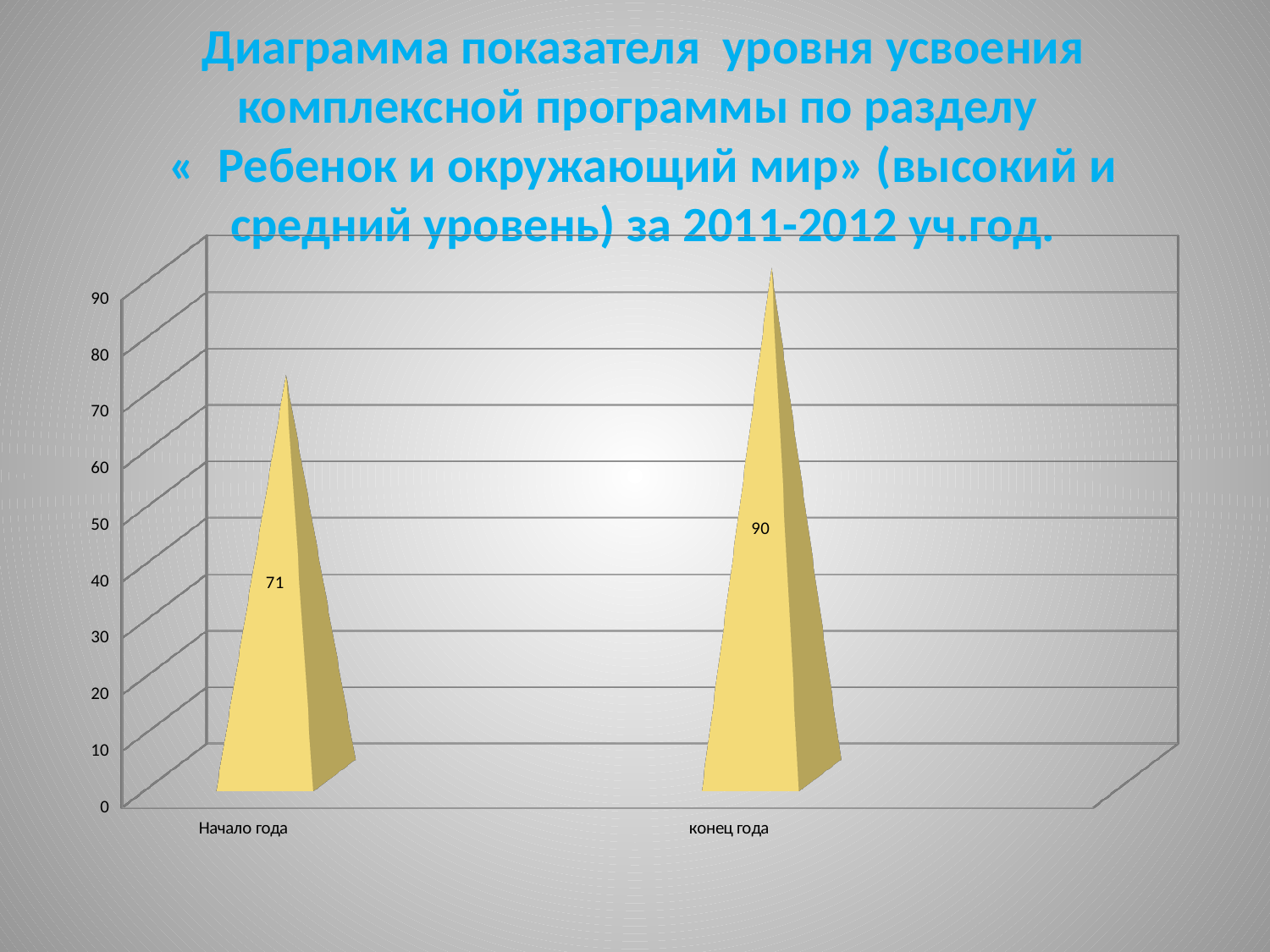
Is the value for Начало года greater or less than 80? less What is the value for Начало года? 71 What is the value for конец года? 90 What kind of chart is shown on the slide? bar chart Which category has the lowest value? Начало года Is the value for конец года greater or less than 80? greater Do the values rise or fall from Начало года to конец года? rise How many categories are shown on the x axis? 2 Which is larger, the value for Начало года or the value for конец года? конец года What is the difference between the values for конец года and Начало года? 19 What is the highest tick value shown on the vertical axis? 90 Which category has the highest value? конец года